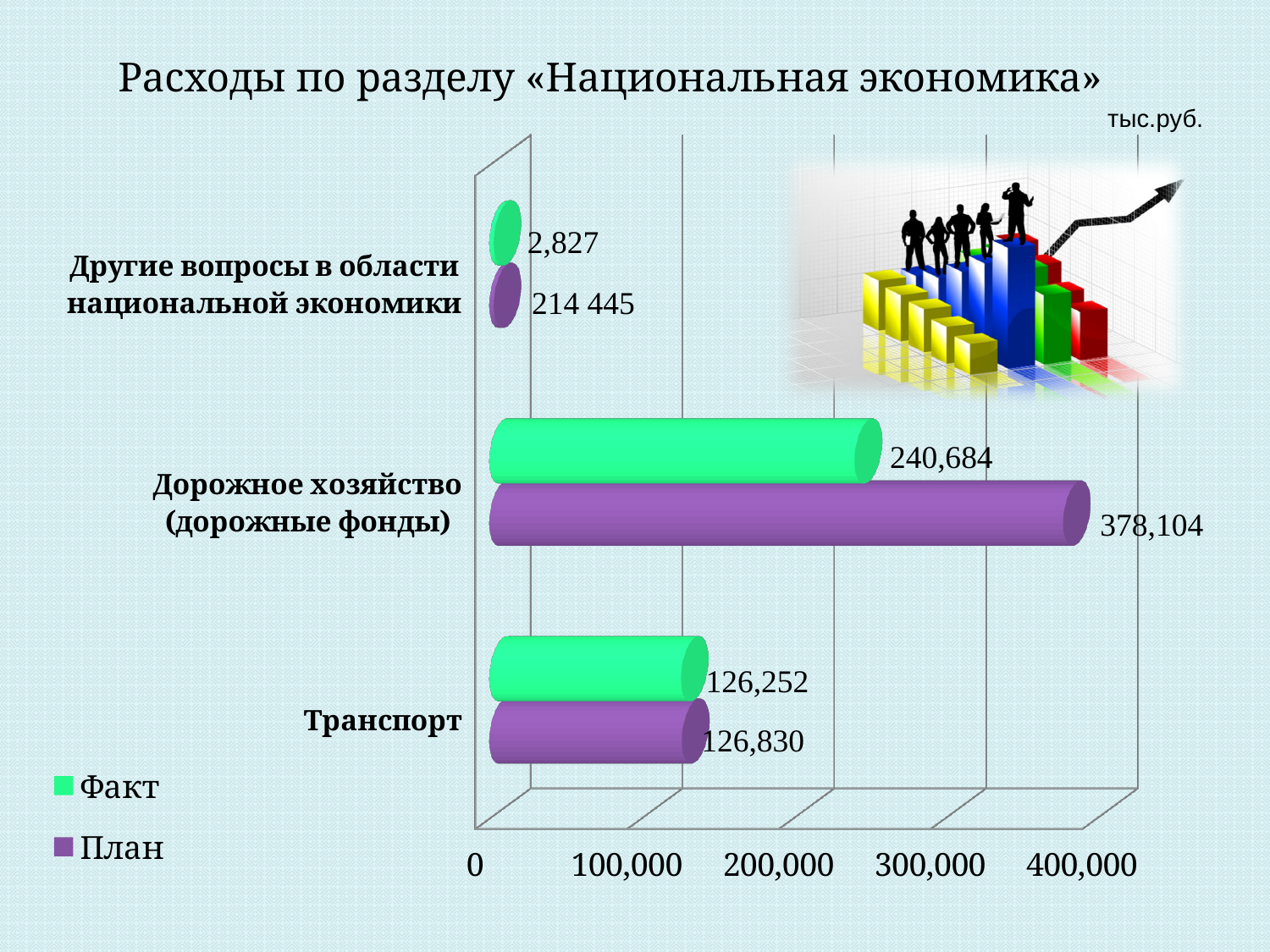
Which category has the lowest Факт value? Другие вопросы в области национальной экономики What is the Факт value for Транспорт? 126,252 What is the Факт value for Другие вопросы в области национальной экономики? 2,827 Which is larger for Дорожное хозяйство (дорожные фонды): the Факт value or the План value? План How many series does the legend list? 2 Which category has the highest Факт value? Дорожное хозяйство (дорожные фонды) What type of chart is shown on the slide? Bar chart What is the План value for Транспорт? 126,830 What is the difference between the План and Факт values for Дорожное хозяйство (дорожные фонды)? 137,420 What is the План value for Дорожное хозяйство (дорожные фонды)? 378,104 How many categories are shown on the chart? 3 What is the Факт value for Дорожное хозяйство (дорожные фонды)? 240,684